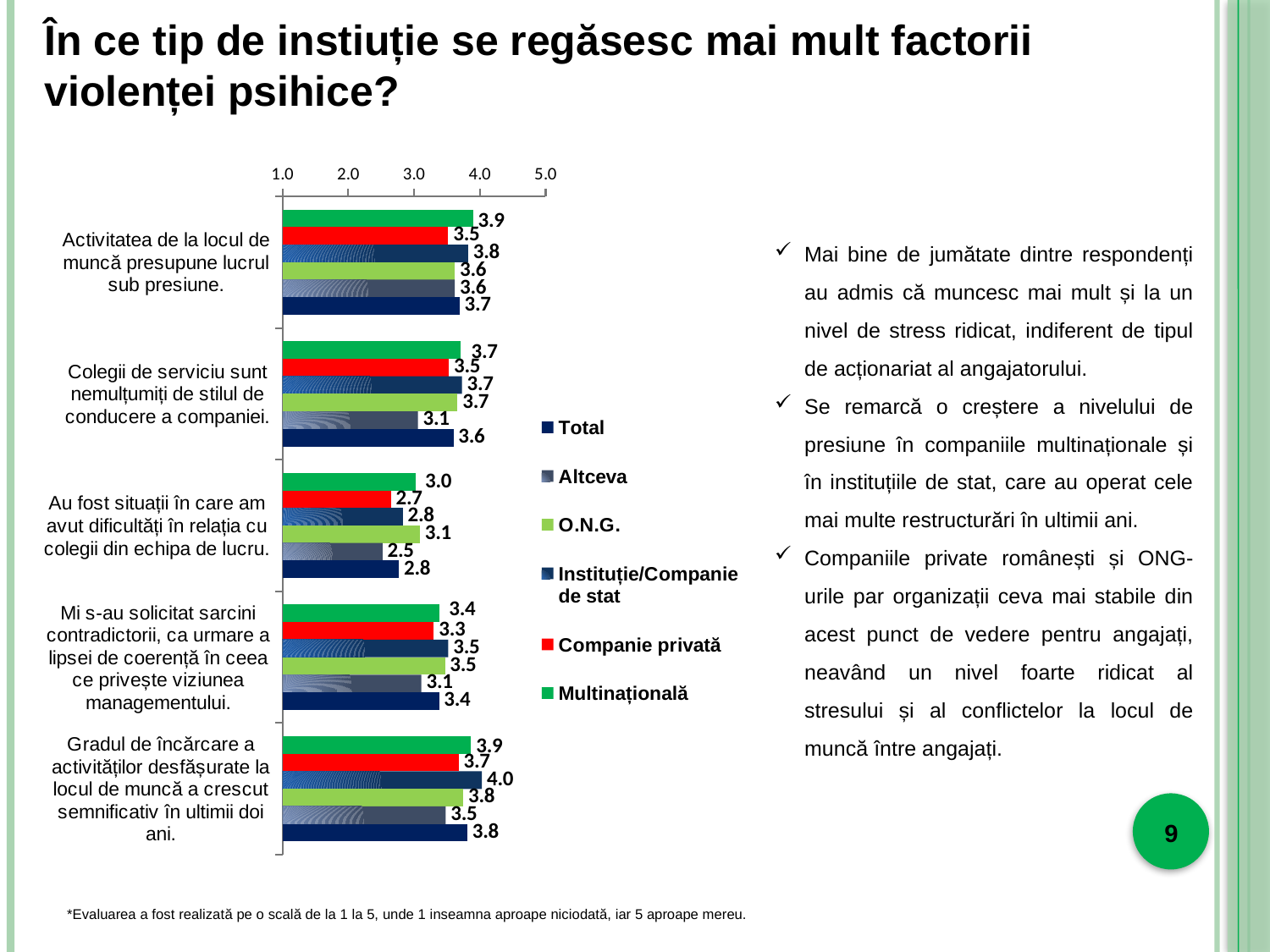
What is the difference between the Multinațională and Companie privată values for "Activitatea de la locul de muncă presupune lucrul sub presiune"? 0.4 What colour represents the Companie privată series in the chart? red For "Mi s-au solicitat sarcini contradictorii...", which is larger: the Instituție/Companie de stat value or the Altceva value? Instituție/Companie de stat Which series has the lowest value for "Colegii de serviciu sunt nemulțumiți de stilul de conducere a companiei"? Altceva What kind of chart is shown on the slide? bar chart Which series has the highest value for "Gradul de încărcare a activităților desfășurate la locul de muncă a crescut semnificativ în ultimii doi ani"? Instituție/Companie de stat What is the Total value for "Activitatea de la locul de muncă presupune lucrul sub presiune"? 3.7 Which statement has the lowest Total value? Au fost situații în care am avut dificultăți în relația cu colegii din echipa de lucru. How many categories (statements) are plotted on the chart? 5 How many series does the chart legend list? 6 What is the Multinațională value for "Gradul de încărcare a activităților desfășurate la locul de muncă a crescut semnificativ în ultimii doi ani"? 3.9 What is the Altceva value for "Au fost situații în care am avut dificultăți în relația cu colegii din echipa de lucru"? 2.5